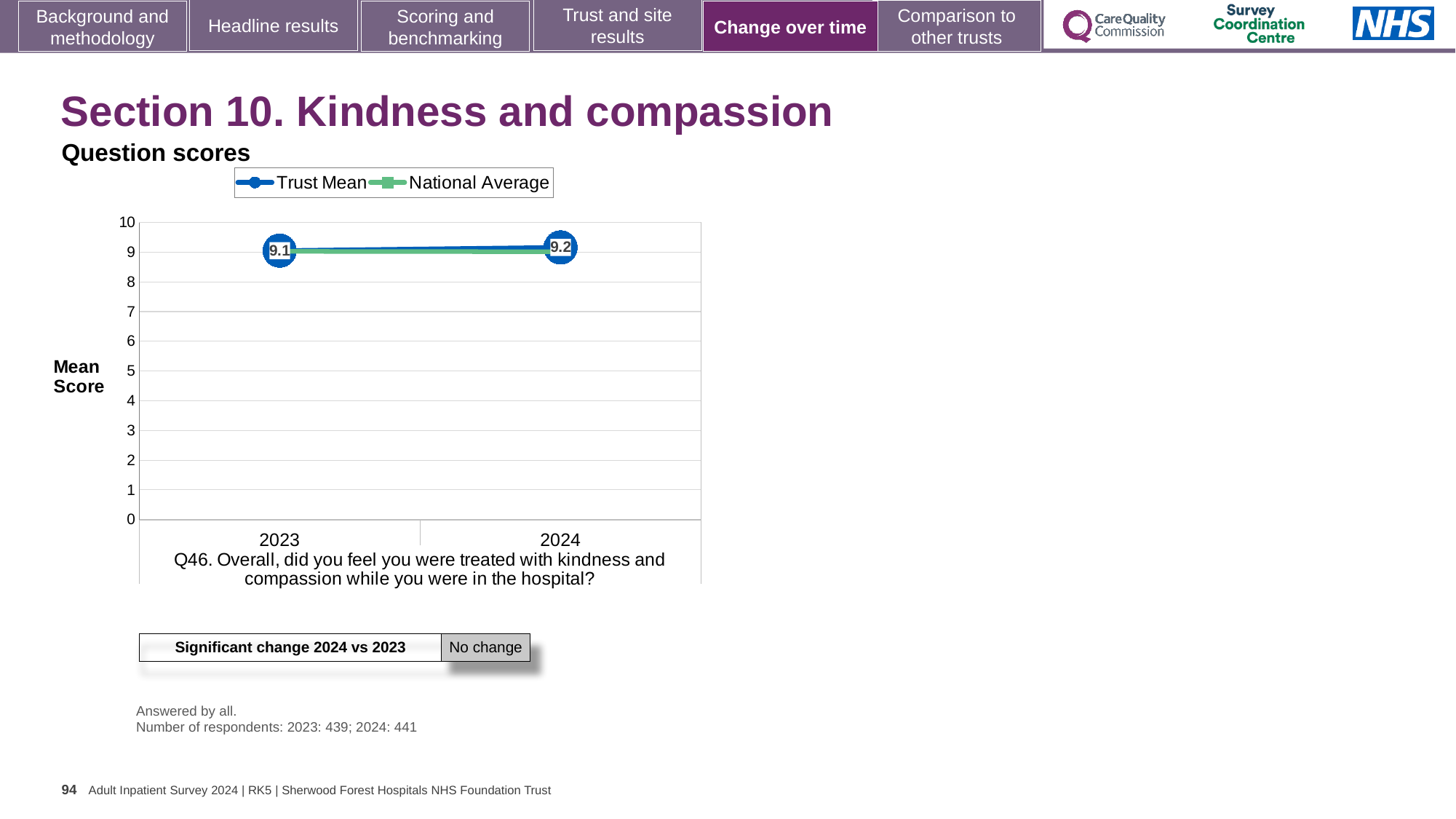
Which year has the higher Trust Mean, 2023 or 2024? 2024 How many years are plotted on the x axis? 2 Is the Trust Mean value for 2023 greater or less than 5? greater What kind of chart is shown? line chart Does the Trust Mean rise or fall from 2023 to 2024? rise By how much did the Trust Mean change from 2023 to 2024? 0.1 What is the label on the y axis? Mean Score What is the Trust Mean score for 2024? 9.2 Is the National Average value for 2024 greater or less than 8? greater What are the two series named in the legend? Trust Mean and National Average How many series does the legend list? 2 What is the Trust Mean score for 2023? 9.1